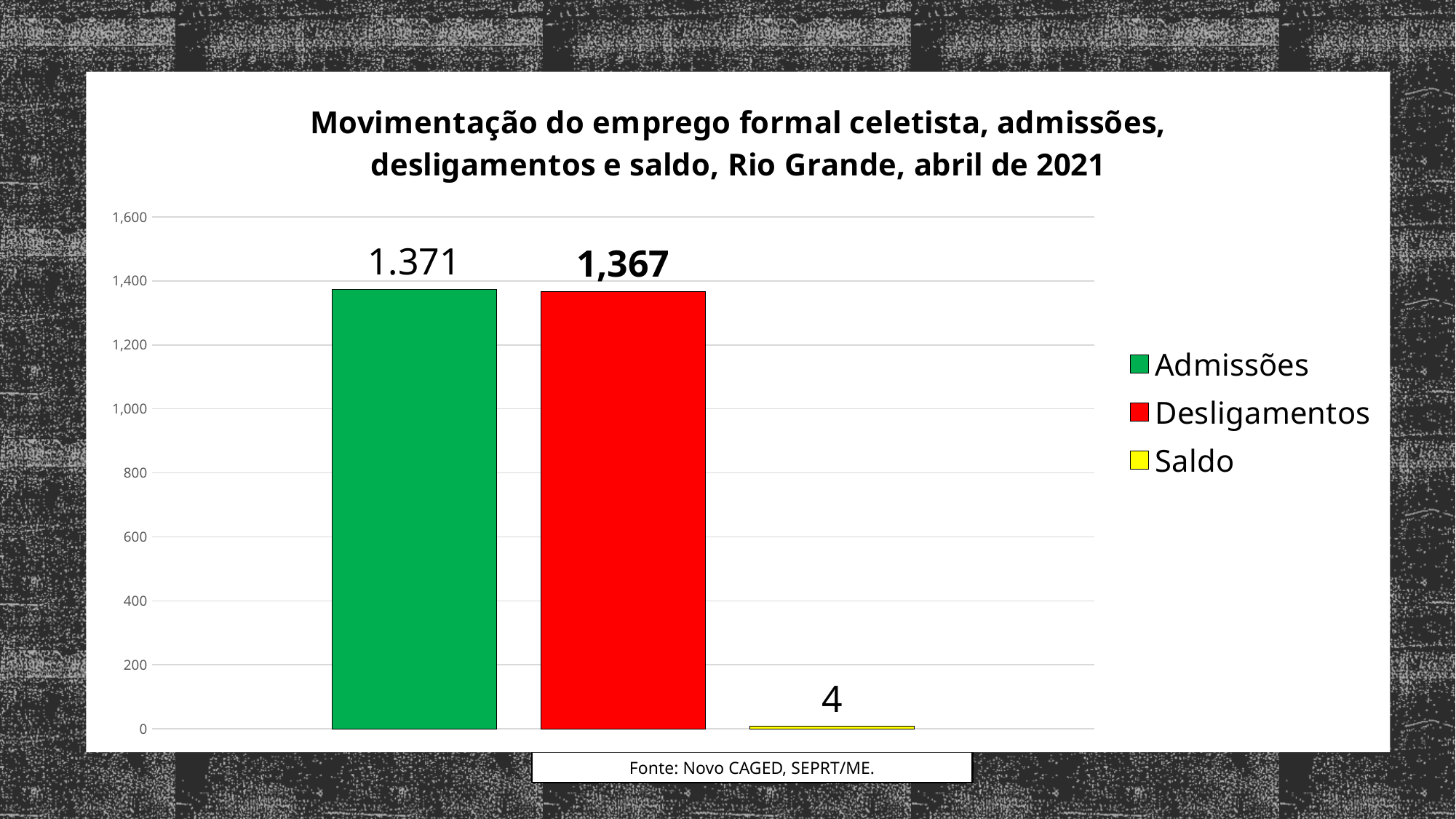
Is the value for Admissões greater or less than 1,200? greater Is the value for Saldo greater or less than 200? less What is the value shown for Saldo? 4 What is the value shown for Admissões? 1.371 What is the value shown for Desligamentos? 1,367 What colour is the bar for Saldo? yellow How many series does the legend list? 3 Which series has the highest value? Admissões What is the difference between the Admissões value and the Desligamentos value? 4 What kind of chart is shown on the slide? bar chart Which series has the lowest value? Saldo Which is larger, the value for Desligamentos or the value for Saldo? Desligamentos